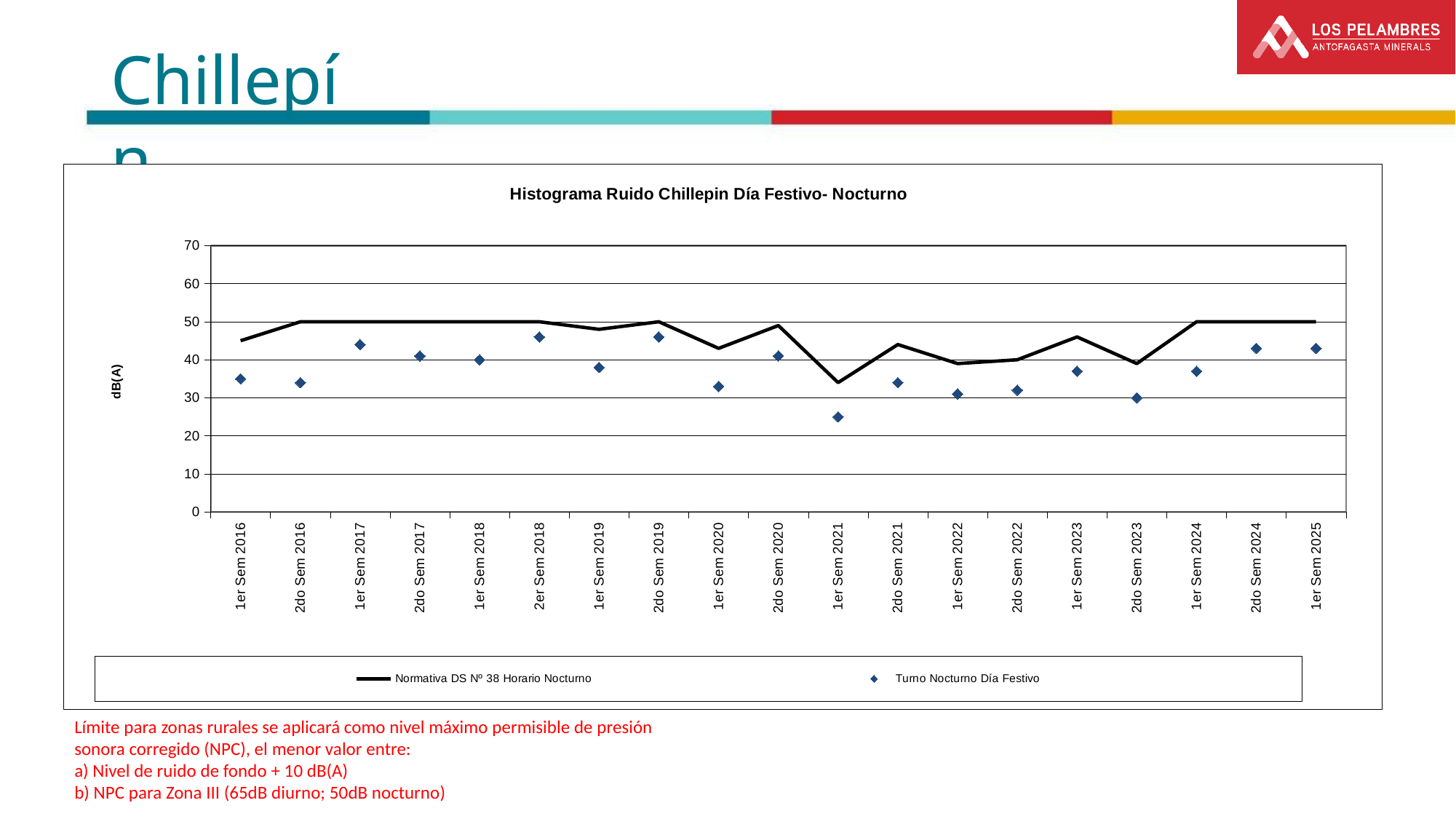
Is the Turno Nocturno Día Festivo value for 2er Sem 2018 greater or less than 40? greater What is the Normativa DS Nº 38 Horario Nocturno value for 1er Sem 2024? 50 Is the Normativa DS Nº 38 Horario Nocturno value for 1er Sem 2021 greater or less than 40? less What kind of chart is shown on the slide? line chart Which has the higher Turno Nocturno Día Festivo value, 1er Sem 2017 or 1er Sem 2020? 1er Sem 2017 What is the title of the chart? Histograma Ruido Chillepin Día Festivo- Nocturno How many semester categories are shown on the x axis? 19 Is the Turno Nocturno Día Festivo value for 1er Sem 2021 greater or less than 30? less In which period is the Turno Nocturno Día Festivo value lowest? 1er Sem 2021 What is the label of the y axis? dB(A) Does the Turno Nocturno Día Festivo value rise or fall from 2do Sem 2023 to 1er Sem 2025? rise How many series does the chart legend list? 2